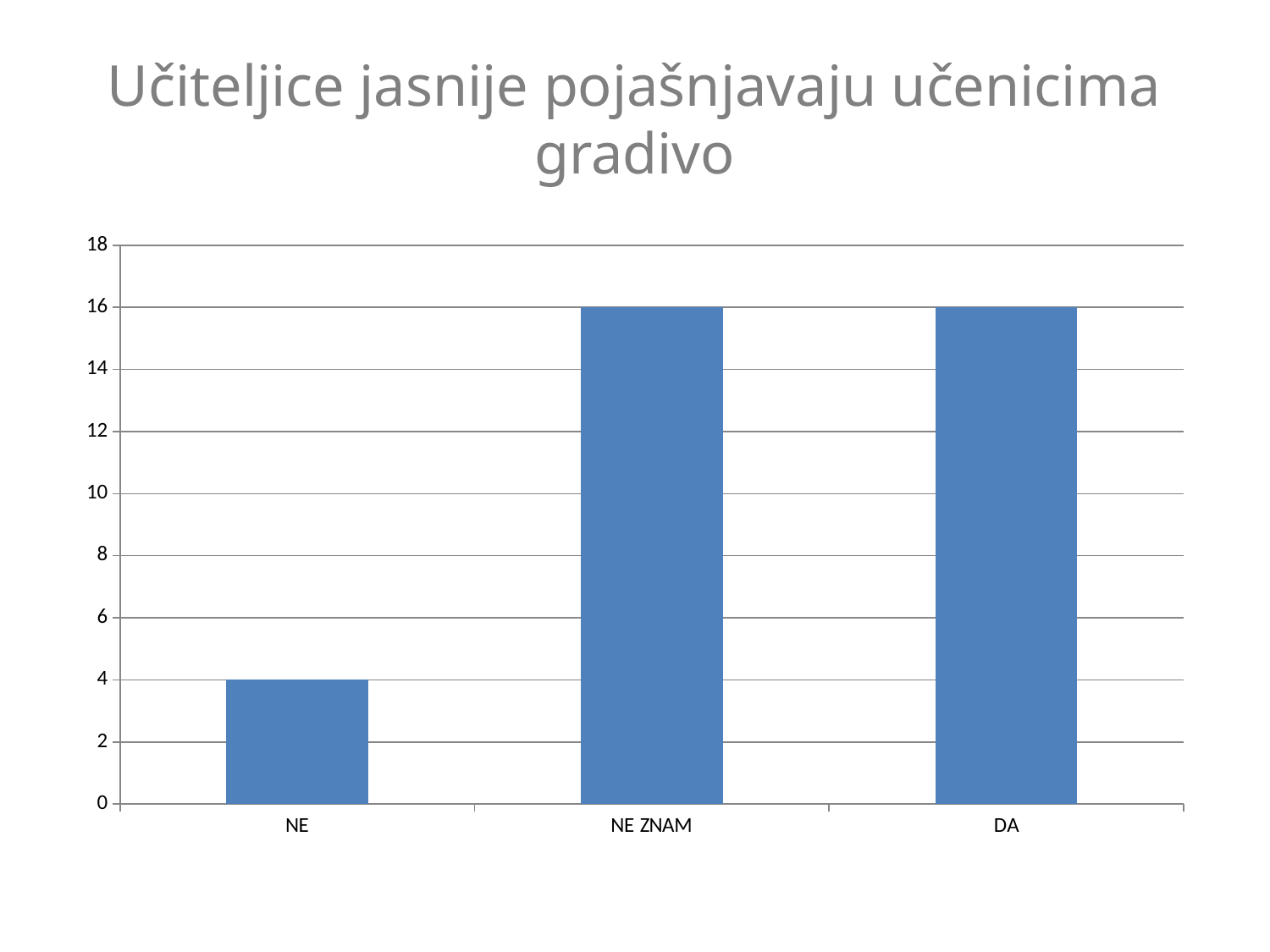
Is the value for DA greater or less than 12? greater What is the value for DA? 16 What is the value for NE ZNAM? 16 What kind of chart is shown on the slide? bar chart Is the value for NE greater or less than 10? less What is the title of the slide? Učiteljice jasnije pojašnjavaju učenicima gradivo How many categories are shown on the x axis? 3 Which is larger, the value for NE ZNAM or the value for NE? NE ZNAM What is the difference between the values for DA and NE? 12 Which category has the lowest value? NE What is the value for NE? 4 What is the highest value shown on the y axis? 18